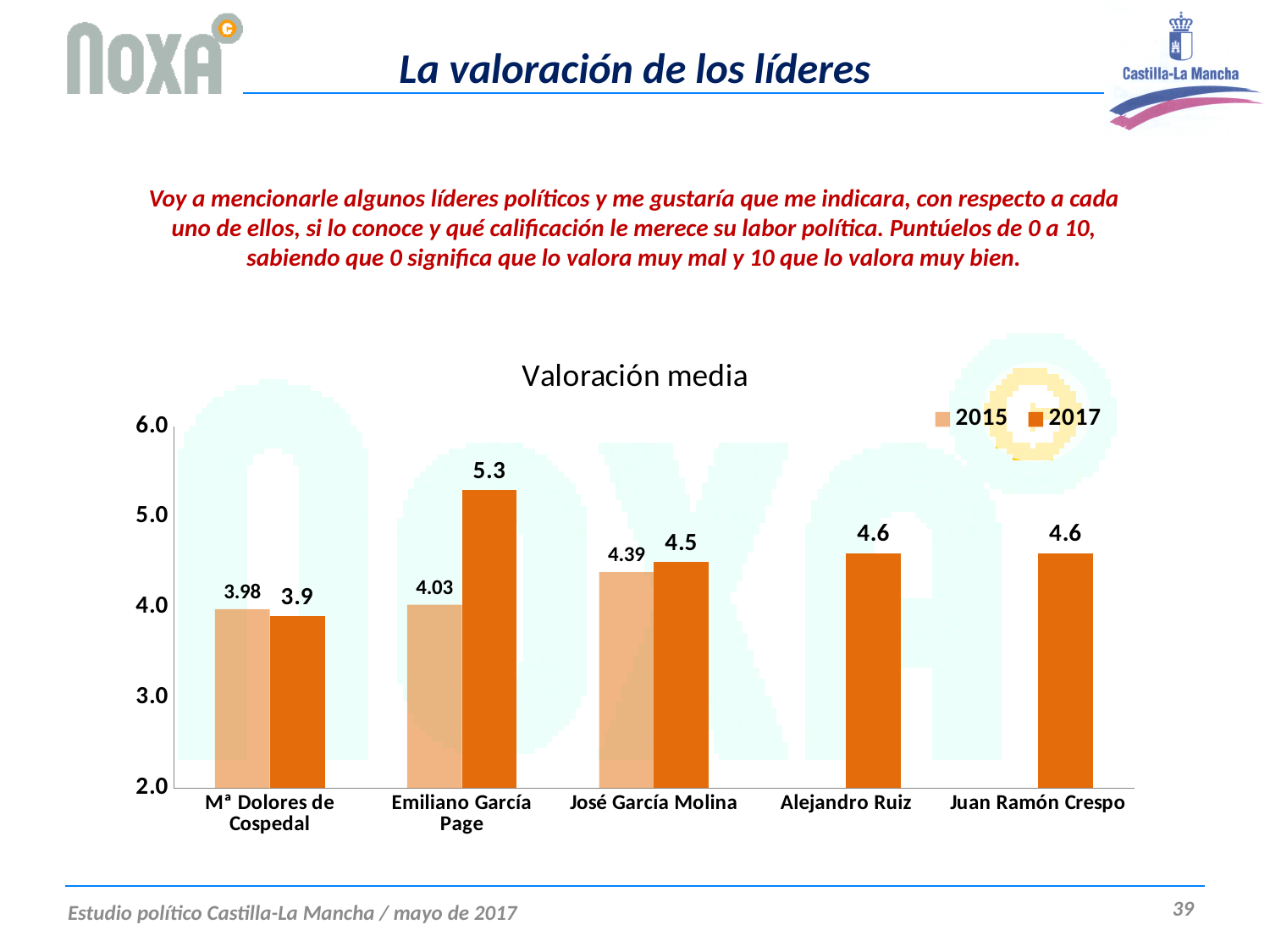
Which leader has the lowest 2017 value? Mª Dolores de Cospedal What is the 2017 value for Mª Dolores de Cospedal? 3.9 Which is larger for Mª Dolores de Cospedal, the 2015 value or the 2017 value? 2015 How many series does the legend list? 2 Is the 2017 value for Alejandro Ruiz greater or less than 4.0? greater What kind of chart is shown? Bar chart What is the 2015 value for José García Molina? 4.39 What is the difference between the 2017 and 2015 values for Emiliano García Page? 1.27 How many leaders are shown on the x axis? 5 What is the 2015 value for Emiliano García Page? 4.03 Which leader has the highest 2017 value? Emiliano García Page What is the 2017 value for Emiliano García Page? 5.3